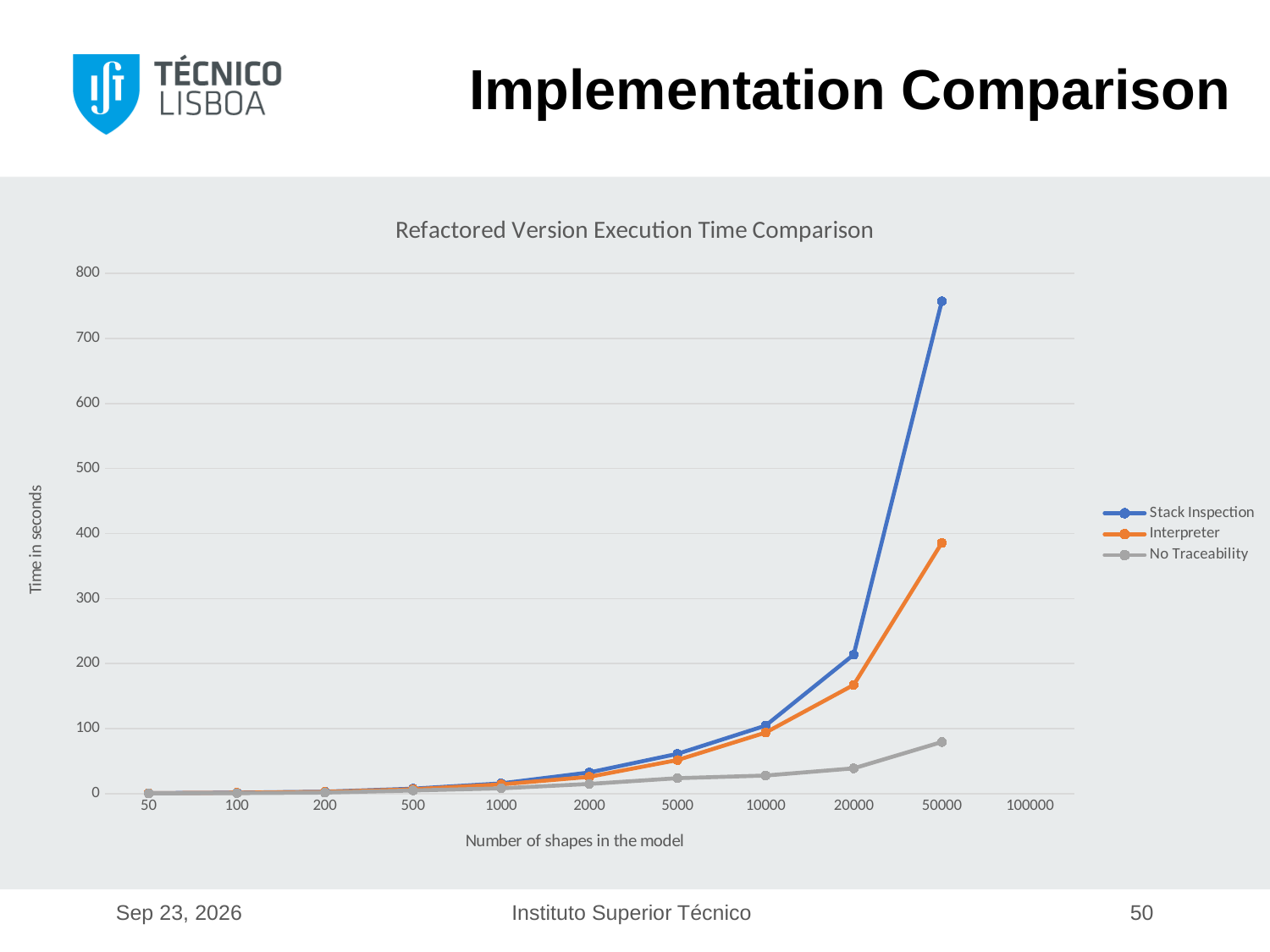
Which series has the lowest value at 50000 shapes? No Traceability Is the value for Interpreter at 50000 shapes greater or less than 300? greater Is the value for Stack Inspection at 50000 shapes greater or less than 700? greater What is the title of the chart? Refactored Version Execution Time Comparison Is the value for Interpreter at 20000 shapes greater or less than 100? greater Which series has the highest value at 50000 shapes? Stack Inspection What is the label of the vertical axis? Time in seconds How many series does the legend list? 3 What kind of chart is shown on the slide? Line chart Do the values for Stack Inspection rise or fall as the number of shapes increases? rise How many values are labelled along the x axis? 11